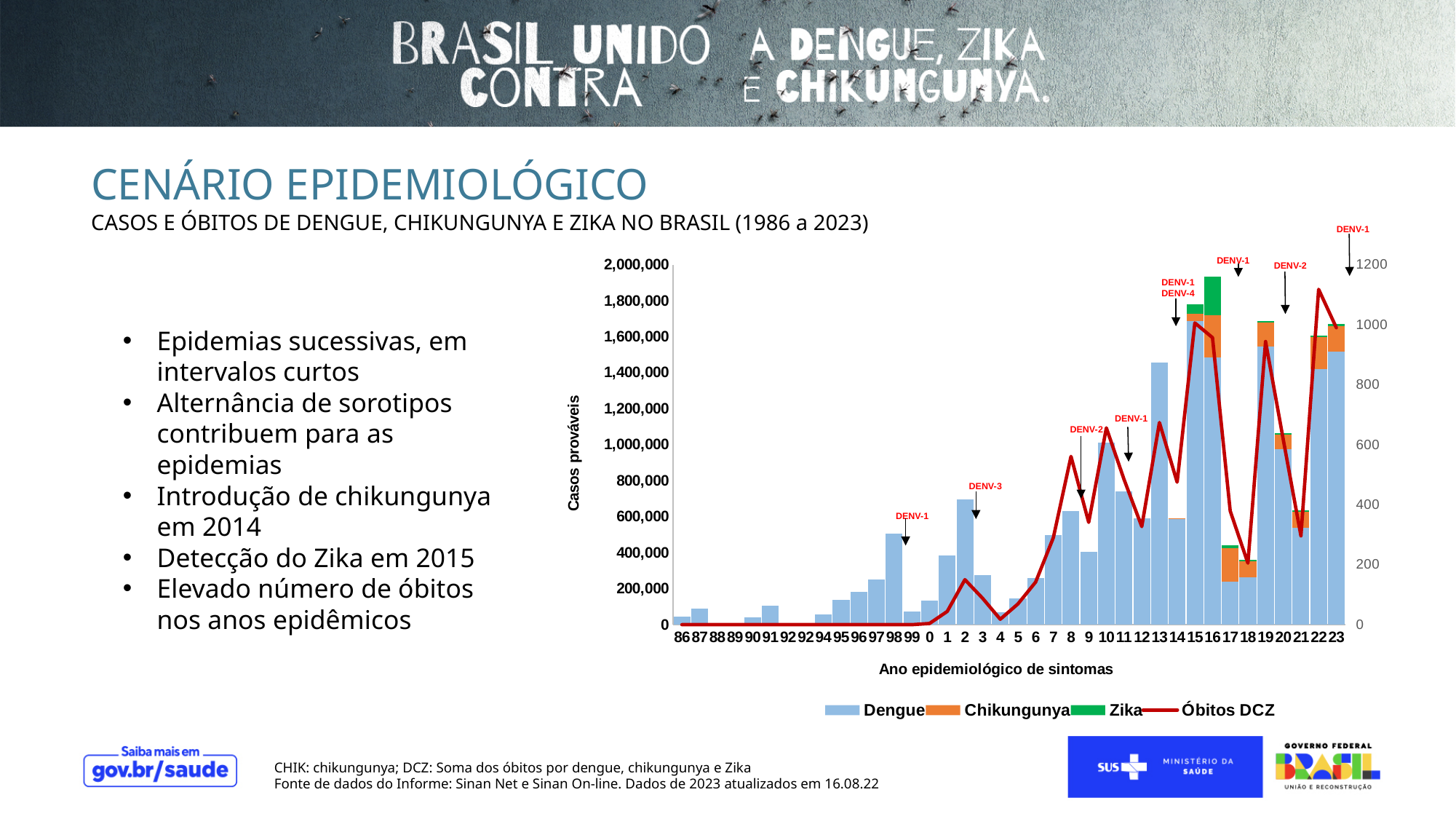
Is the total of the stacked bar for year 16 greater or less than 1,800,000? greater How many years (categories) are shown on the x axis of the chart? 38 Which stacked bar is taller, year 13 or year 10? 13 Is the Óbitos DCZ line value for year 21 greater or less than 400 on the right axis? less Do the probable cases generally rise or fall from 86 to 23 along the x axis? rise Is the Óbitos DCZ line value for year 22 greater or less than 1000 on the right axis? greater What colour represents Zika in the chart legend? Green What kind of chart is shown on the slide? Stacked bar chart with a line Which year has the highest stacked bar of probable cases? 16 How many series does the chart legend list? 4